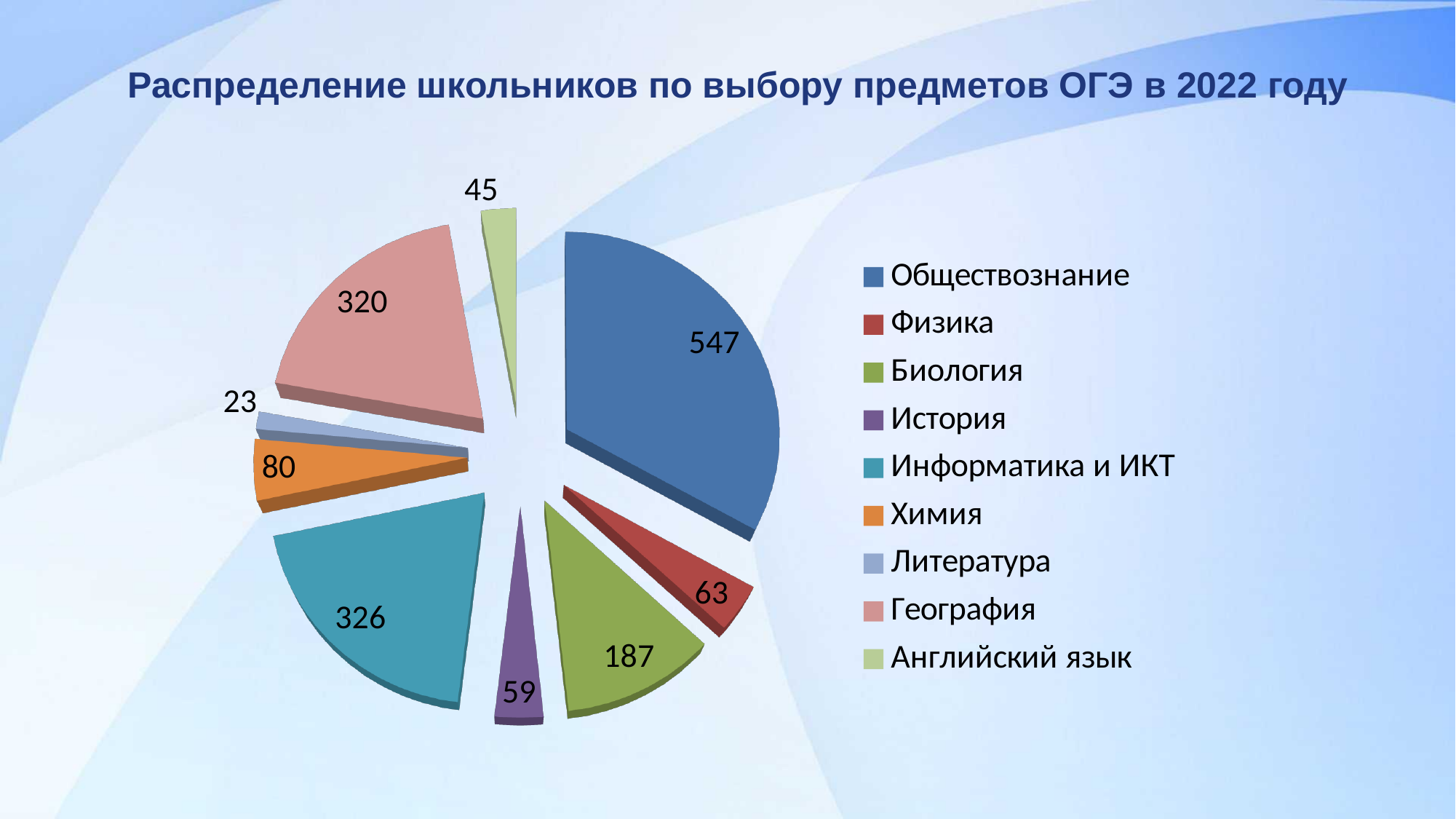
Which subject has the smallest slice of the pie? Литература What is the value for Литература? 23 How many students chose Обществознание? 547 How many subjects are shown in the pie chart? 9 What is the difference between the values for Физика and История? 4 What kind of chart is shown on the slide? pie chart What is the difference between the values for Обществознание and Информатика и ИКТ? 221 What is the value for География? 320 Which is larger, the value for Биология or the value for Химия? Биология What is the value for Информатика и ИКТ? 326 Which subject has the largest slice of the pie? Обществознание What is the title of the chart? Распределение школьников по выбору предметов ОГЭ в 2022 году